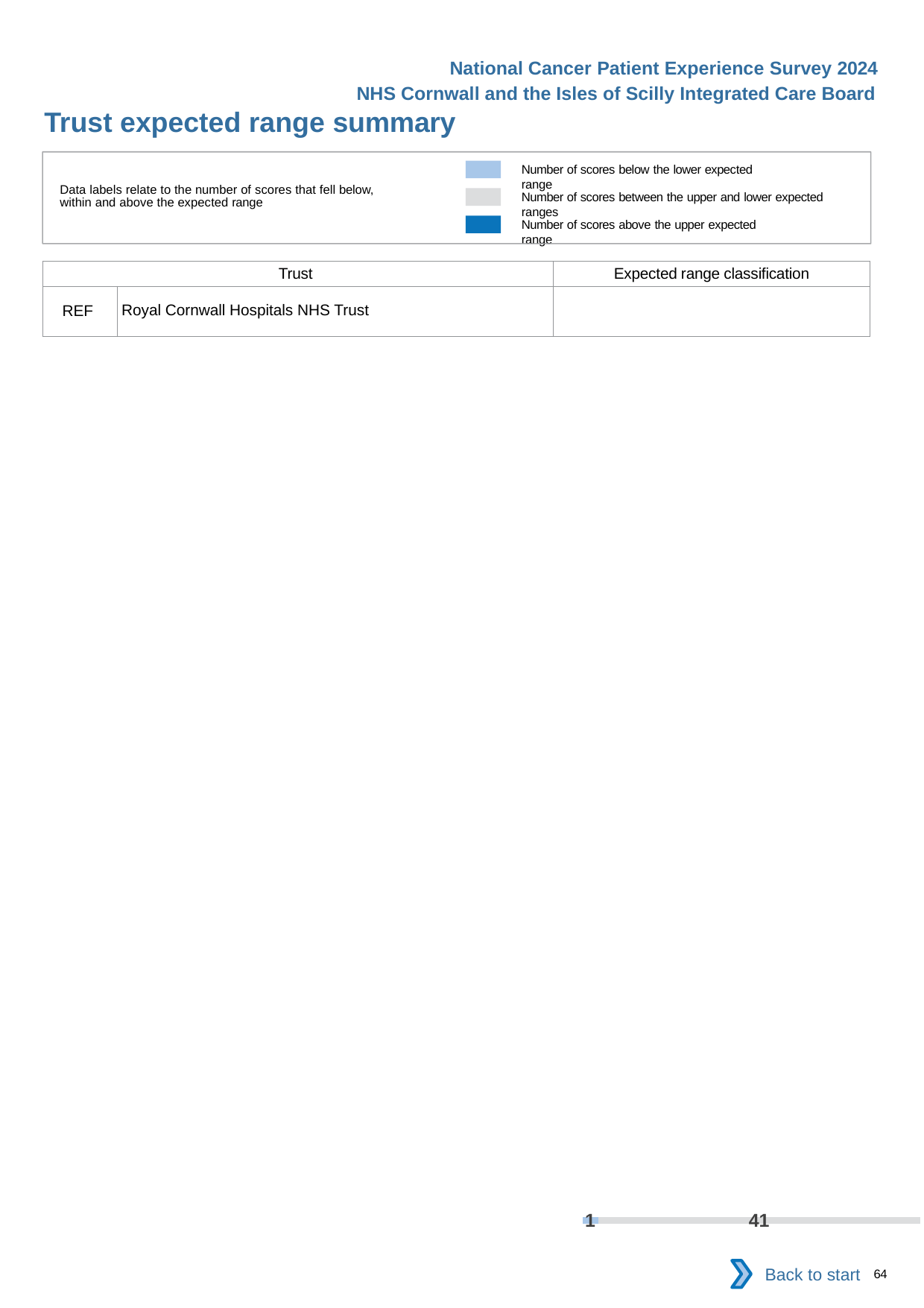
What is the difference between the grey segment value and the light blue segment value in the stacked bar at the bottom of the slide? 40 According to the key, what does the dark blue colour represent? Number of scores above the upper expected range In the stacked bar at the bottom of the slide, what is the value of the light blue segment (number of scores below the lower expected range)? 1 What is the total of the two labelled segments in the stacked bar at the bottom of the slide? 42 What kind of chart is shown at the bottom of the slide? stacked bar chart How many categories does the legend in the key box list? 3 In the stacked bar at the bottom of the slide, what is the value of the grey segment (number of scores between the upper and lower expected ranges)? 41 In the stacked bar at the bottom of the slide, which segment is larger: the light blue segment or the grey segment? grey segment Which trust is listed in the table on the slide? Royal Cornwall Hospitals NHS Trust